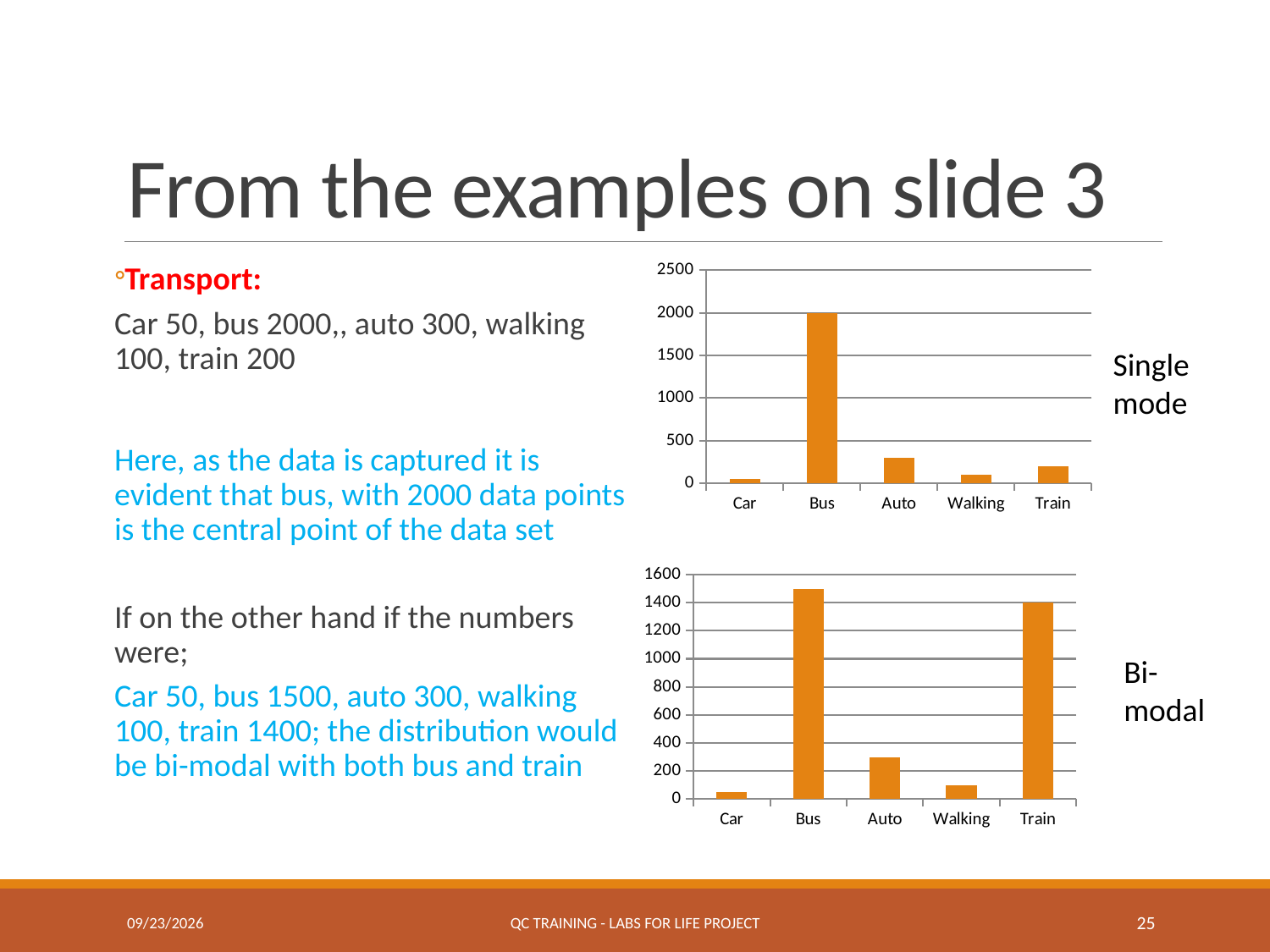
In the bottom chart, which category has the lowest value? Car What label is written to the right of the bottom chart? Bi-modal How many categories are shown on the x axis of the top chart? 5 In the bottom chart, is the value for Walking greater or less than 200? less In the top chart, which category has the highest value? Bus In the top chart, what is the value for Bus? 2000 In the bottom chart, which category has the highest value? Bus In the top chart, which is larger, the value for Auto or the value for Train? Auto In the bottom chart, what is the value for Train? 1400 In the top chart, which category has the lowest value? Car What kind of chart is the top chart on the slide? bar chart In the top chart, is the value for Auto greater or less than 500? less